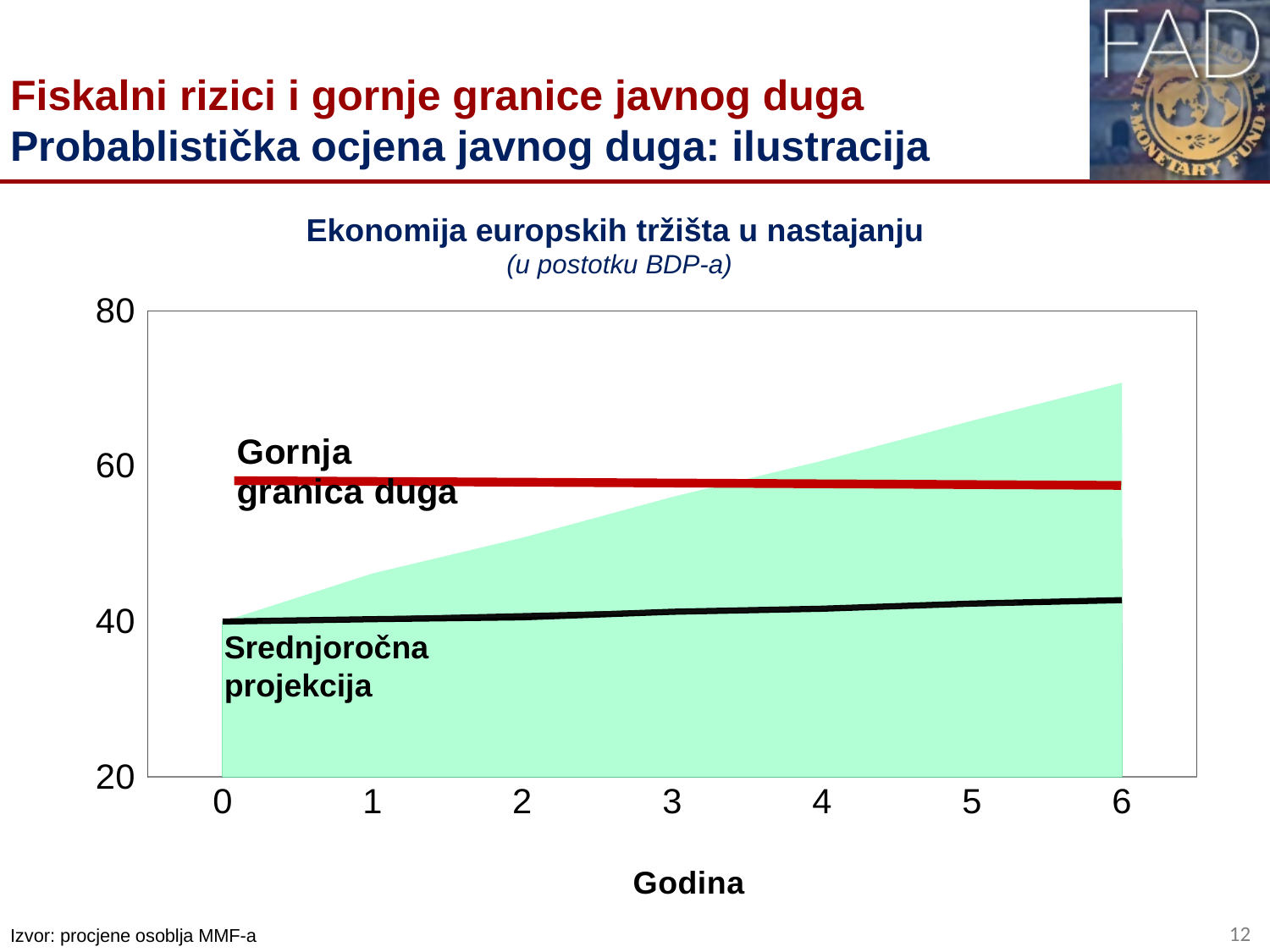
At year 6, which is higher: Gornja granica duga or Srednjoročna projekcija? Gornja granica duga Is the value of Gornja granica duga at year 0 greater or less than 40? greater Which of the two labelled lines stays lower across the whole chart? Srednjoročna projekcija Is the upper edge of the shaded area at year 6 greater or less than 60? greater What is the title of the chart? Ekonomija europskih tržišta u nastajanju What is the label of the x axis? Godina How many year ticks are labelled on the x axis? 7 Does the Srednjoročna projekcija line rise or fall from year 0 to year 6? rises Is the value of Gornja granica duga at year 3 greater or less than 60? less What kind of chart is shown on the slide? area and line chart